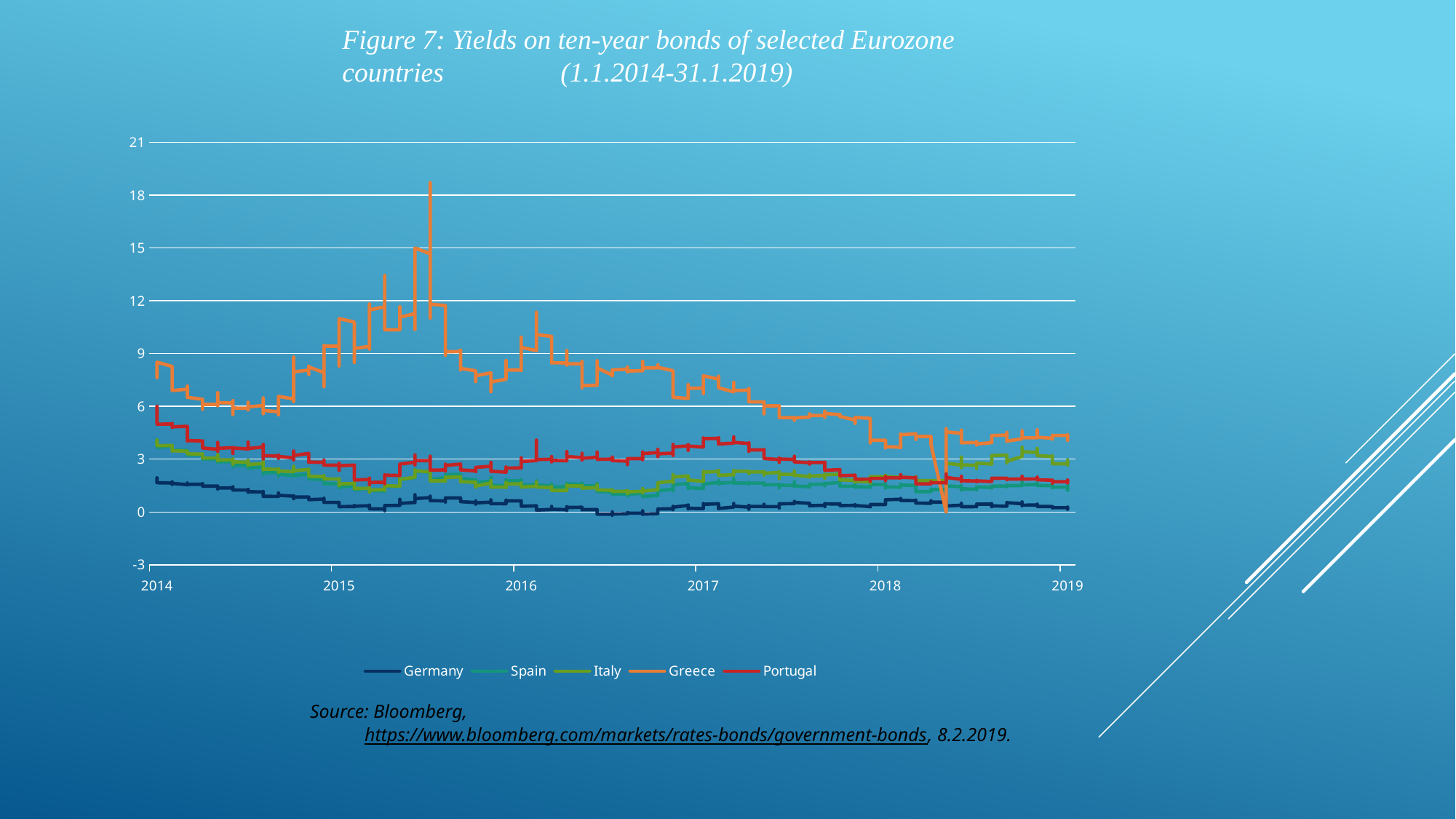
How many series does the legend list? 5 Is the value for Germany at the start of 2014 greater or less than 3? less Is the value for Greece at the start of 2014 greater or less than 6? greater Which country has the lowest ten-year bond yield over the period shown? Germany What is the title of the chart? Figure 7: Yields on ten-year bonds of selected Eurozone countries (1.1.2014-31.1.2019) What is the highest value shown on the vertical axis? 21 Which is larger in mid-2015, the yield for Greece or the yield for Germany? Greece What kind of chart is shown on the slide? line chart Which countries are listed in the legend? Germany, Spain, Italy, Greece, Portugal Is the peak value for Greece in 2015 greater or less than 15? greater Does the yield for Greece rise or fall between its 2015 peak and the end of the period in 2019? fall Which country has the highest ten-year bond yield over the period shown? Greece